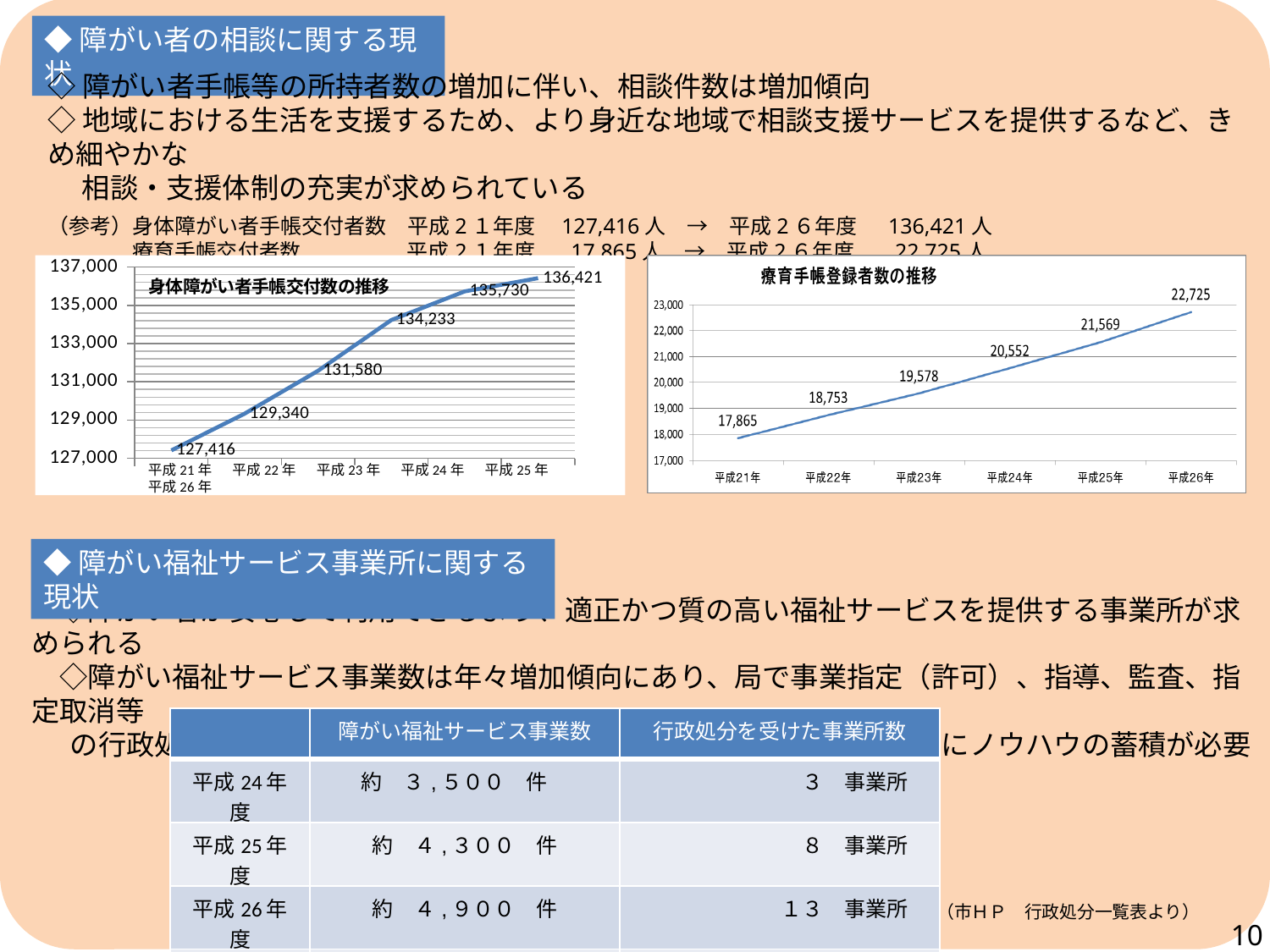
In the chart titled 身体障がい者手帳交付数の推移, what is the difference between the values for 平成 26 年 and 平成 21 年? 9,005 In the chart titled 療育手帳登録者数の推移, is the value for 平成22年 greater or less than 19,000? less In the chart titled 療育手帳登録者数の推移, what is the value for 平成23年? 19,578 In the chart titled 療育手帳登録者数の推移, what is the value for 平成26年? 22,725 In the chart titled 身体障がい者手帳交付数の推移, what is the value for 平成 21 年? 127,416 What kind of chart is the chart titled 身体障がい者手帳交付数の推移? line chart In the chart titled 療育手帳登録者数の推移, what is the difference between the values for 平成25年 and 平成24年? 1,017 In the chart titled 身体障がい者手帳交付数の推移, do the values rise or fall from 平成 21 年 to 平成 26 年? rise In the chart titled 身体障がい者手帳交付数の推移, what is the value for 平成 24 年? 134,233 In the chart titled 療育手帳登録者数の推移, how many data points are plotted? 6 In the chart titled 療育手帳登録者数の推移, which year has the lowest value? 平成21年 In the chart titled 身体障がい者手帳交付数の推移, which year has the highest value? 平成 26 年